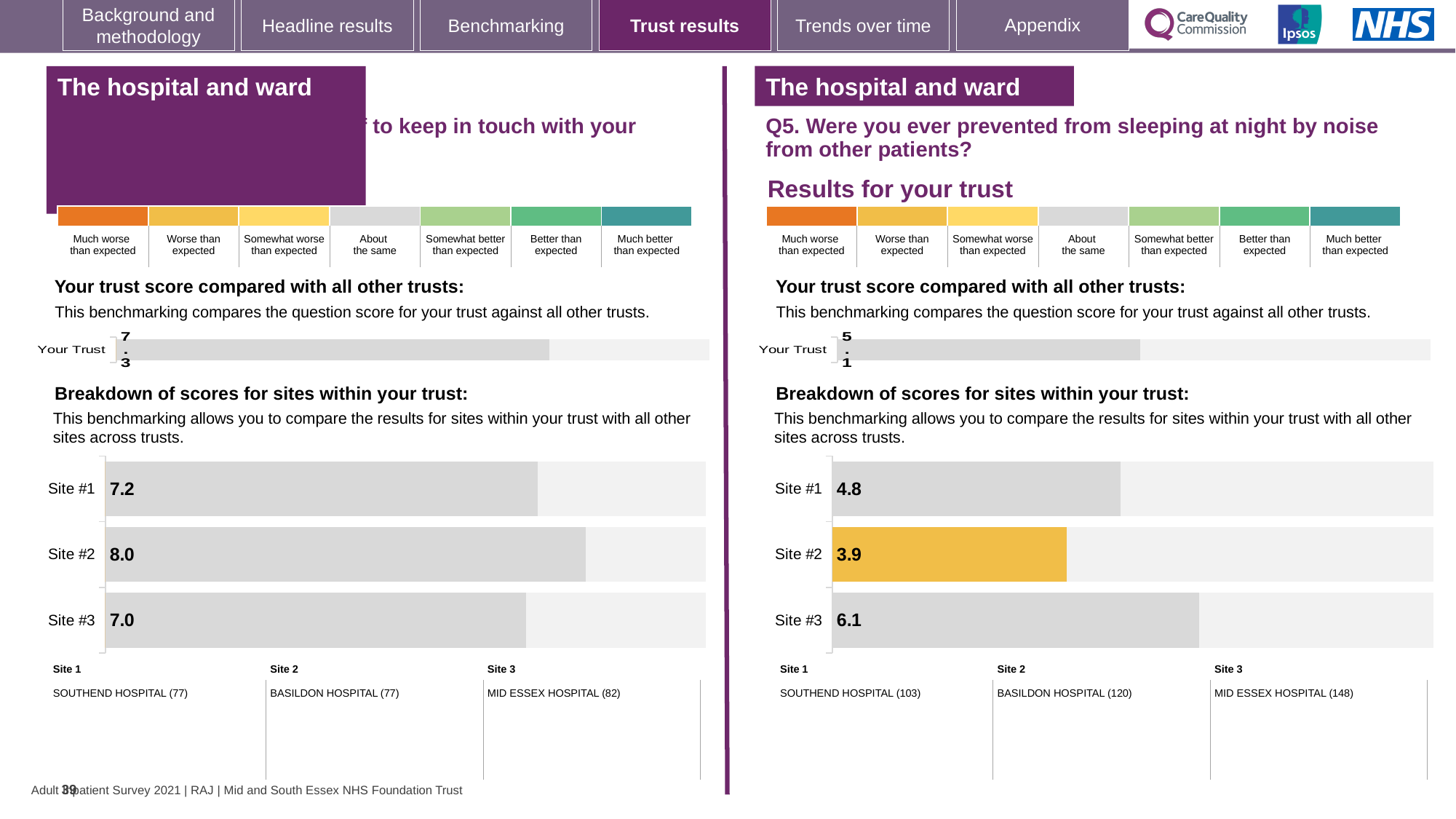
What type of chart is used for the site breakdown on the right-hand side of the slide? bar chart On the right-hand chart for Q5, what is the score for Site #3? 6.1 On the left-hand site breakdown chart, what is the difference between the scores for Site #2 and Site #1? 0.8 On the left-hand site breakdown chart, which site has the lowest score? Site #3 On the right-hand side of the slide, what is the 'Your Trust' score for Q5? 5.1 On the right-hand chart for Q5, what is the difference between the scores for Site #3 and Site #2? 2.2 On the right-hand chart for Q5, which site has the lowest score? Site #2 On the left-hand site breakdown chart, is the score for Site #1 larger or smaller than the score for Site #3? larger How many sites are shown in the right-hand site breakdown chart for Q5? 3 On the right-hand chart for Q5 (prevented from sleeping by noise from other patients), what is the score for Site #2? 3.9 On the left-hand site breakdown chart, what is the score for Site #2? 8.0 On the right-hand chart for Q5, which site has the highest score? Site #3